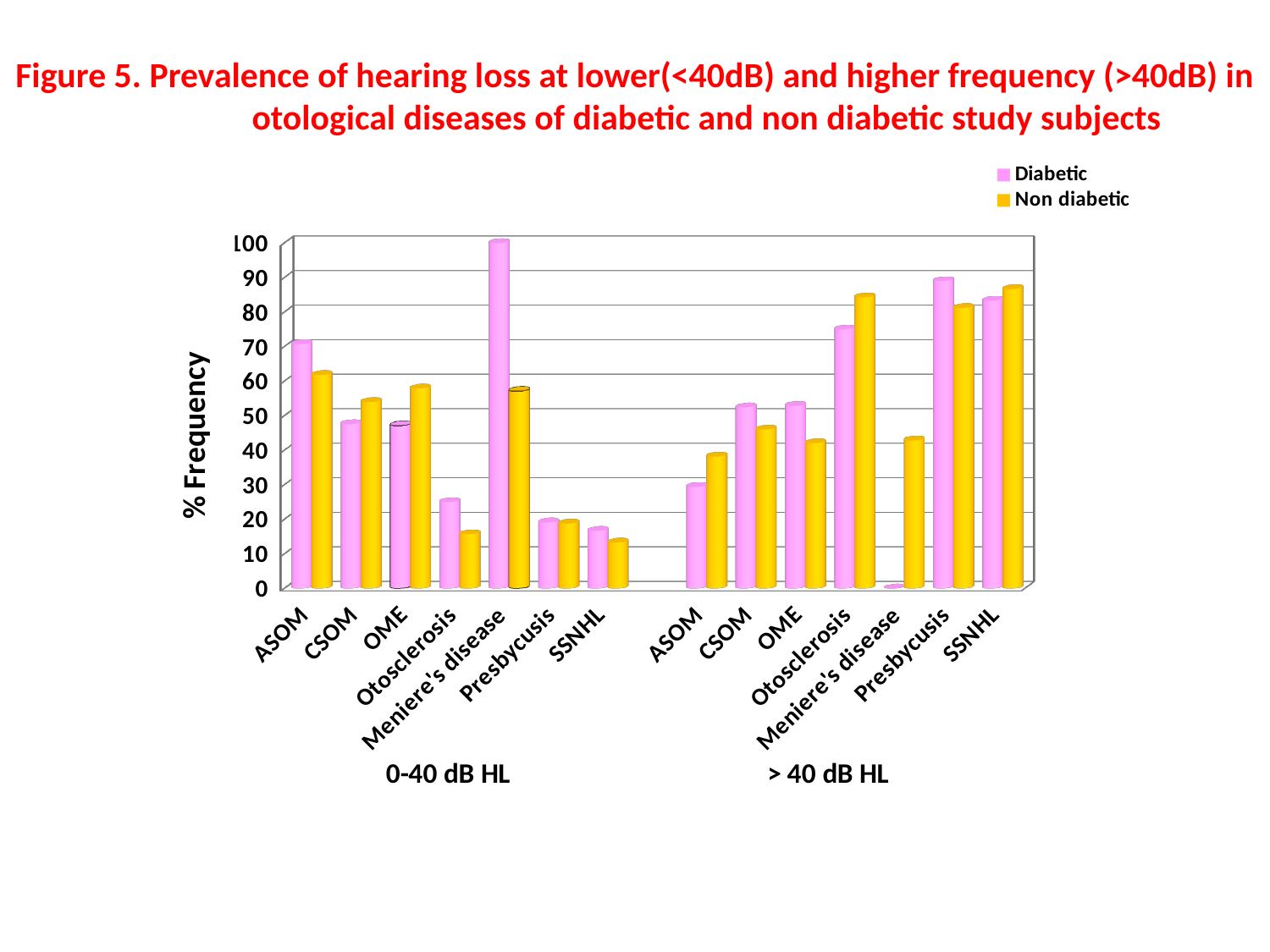
How many series does the legend list? 2 Which category has the highest Diabetic bar on the chart? Meniere's disease (0-40 dB HL) In the > 40 dB HL group, is the Non diabetic value for Otosclerosis greater or less than 80? greater What is the label on the y axis of the chart? % Frequency In the 0-40 dB HL group, which is larger for OME: the Diabetic or the Non diabetic value? Non diabetic Which category has the lowest Diabetic bar on the chart? Meniere's disease (> 40 dB HL) In the 0-40 dB HL group, is the Diabetic value for SSNHL greater or less than 20? less In the 0-40 dB HL group, is the Diabetic value for ASOM greater or less than 60? greater In the > 40 dB HL group, which is larger for Presbycusis: the Diabetic or the Non diabetic value? Diabetic How many category labels are shown along the x axis? 14 What kind of chart is shown on the slide? bar chart